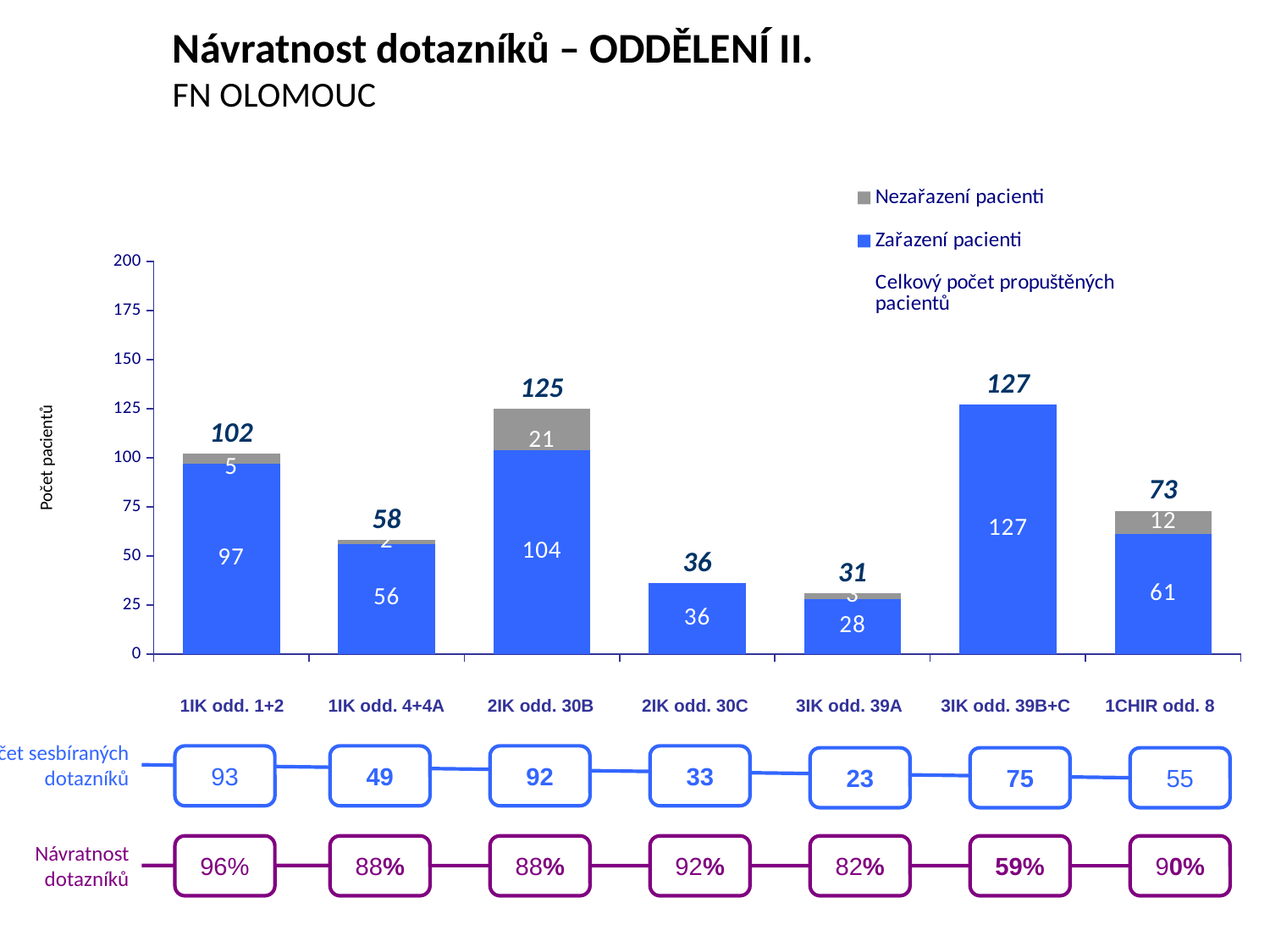
What is the difference in Zařazení pacienti between 1IK odd. 1+2 and 1IK odd. 4+4A? 41 What is the value of Zařazení pacienti for 2IK odd. 30B? 104 What colour represents Nezařazení pacienti in the chart? grey What is the value of Nezařazení pacienti for 1CHIR odd. 8? 12 Which department has the highest total number of discharged patients? 3IK odd. 39B+C Which department has the lowest total number of discharged patients? 3IK odd. 39A How many series does the chart legend list? 3 Is the total value for 2IK odd. 30C greater or less than 50? less How many departments (categories) are shown on the x axis of the chart? 7 What is the total number of patients (Celkový počet propuštěných pacientů) for 2IK odd. 30B? 125 Which has more Zařazení pacienti, 1CHIR odd. 8 or 1IK odd. 4+4A? 1CHIR odd. 8 What kind of chart is shown on the slide? stacked bar chart